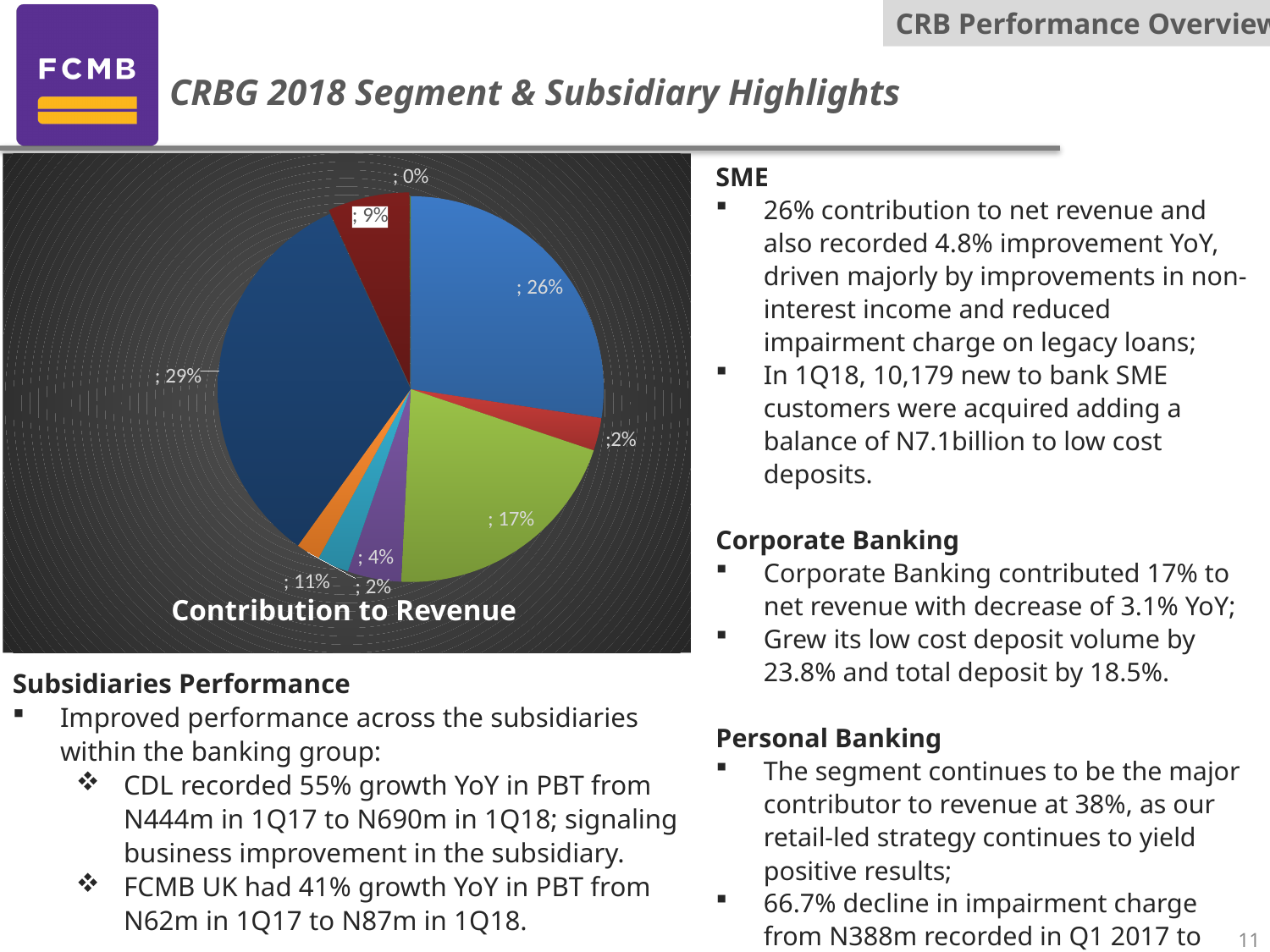
What percentage is labelled on the dark red slice of the Contribution to Revenue pie chart? 9% What kind of chart is shown on the slide? pie chart What is the largest percentage labelled on the Contribution to Revenue pie chart? 29% How many slices on the Contribution to Revenue pie chart are labelled 2%? 2 What percentage is labelled on the dark navy slice of the Contribution to Revenue pie chart? 29% What is the difference between the 29% slice and the 26% slice on the Contribution to Revenue pie chart? 3 percentage points What percentage is labelled on the light blue slice of the Contribution to Revenue pie chart? 26% What is the title of the chart on the slide? Contribution to Revenue What percentage is labelled on the green slice of the Contribution to Revenue pie chart? 17% What is the smallest percentage labelled on the Contribution to Revenue pie chart? 0% Which slice is larger on the Contribution to Revenue pie chart, the light blue slice or the green slice? the light blue slice How many slices are labelled on the Contribution to Revenue pie chart? 9